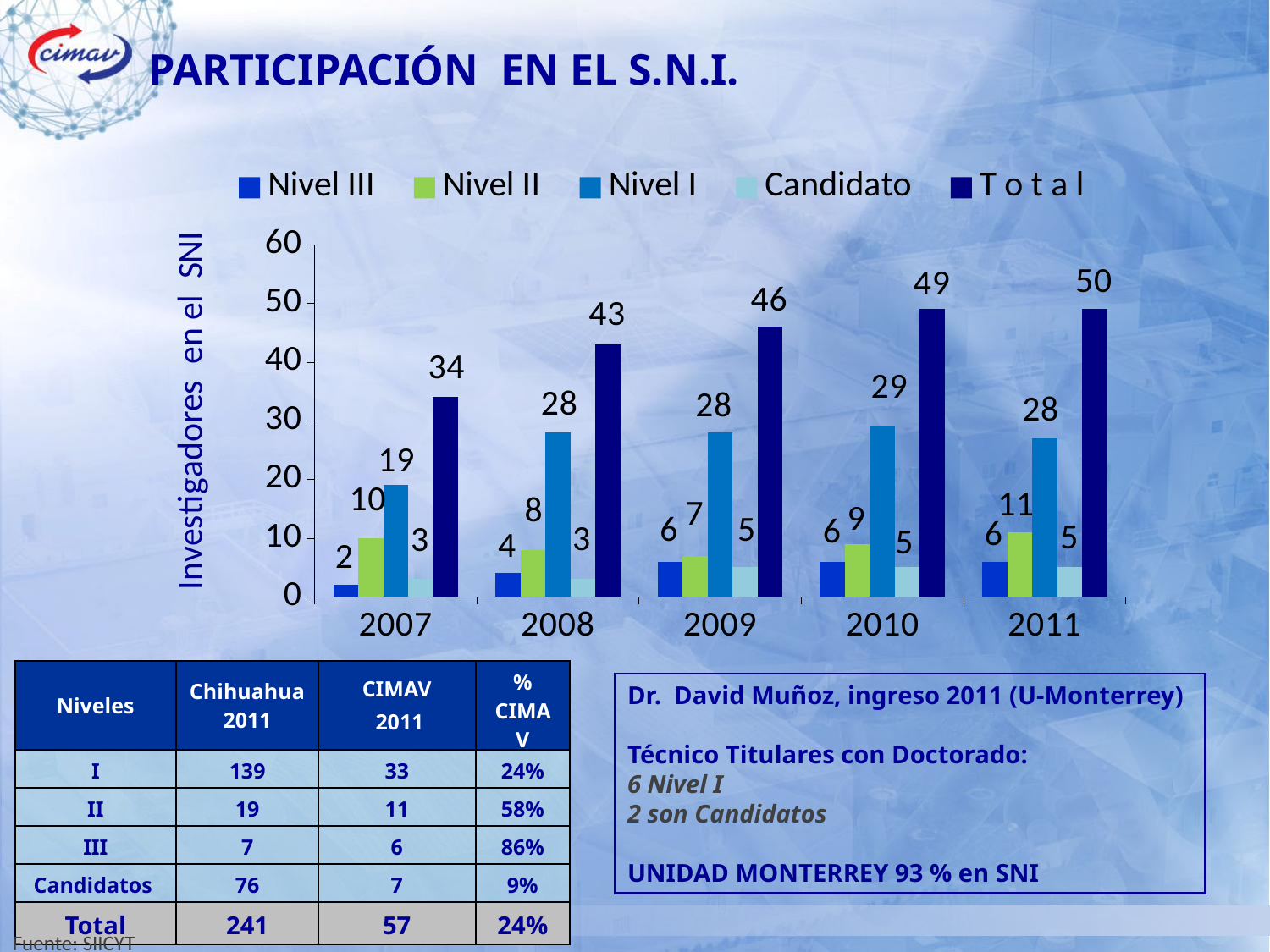
In which year is the Nivel III value lowest? 2007 What is the Total value for 2011? 50 What is the Nivel I value for 2007? 19 What is the Nivel II value for 2011? 11 What is the Candidato value for 2009? 5 In which year is the Total highest? 2011 Which is larger, the Nivel II value for 2007 or the Nivel II value for 2008? 2007 What is the difference between the Total for 2011 and the Total for 2007? 16 How many series does the legend list? 5 What kind of chart is shown on the slide? bar chart Does the Total rise or fall from 2007 to 2011? rise How many years are shown on the x axis? 5